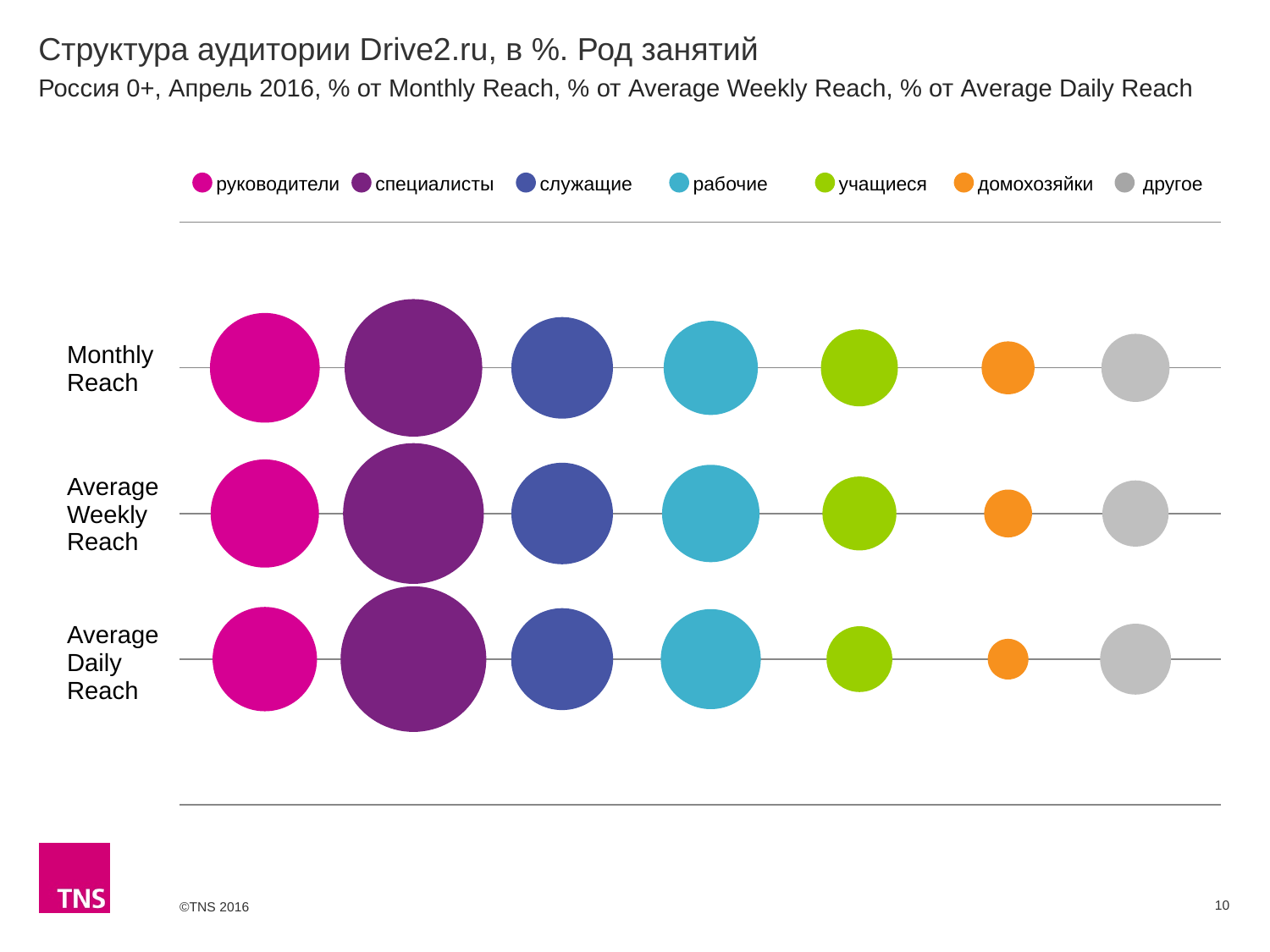
Which legend entry is shown in orange? домохозяйки Which occupation group has the largest bubble in the Average Daily Reach row? специалисты Which occupation group has the smallest bubble in the Monthly Reach row? домохозяйки What is the title of the chart on the slide? Структура аудитории Drive2.ru, в %. Род занятий In the Monthly Reach row, which bubble is larger: другое or домохозяйки? другое What kind of chart is shown on the slide? Bubble chart How many reach categories (rows) are plotted on the chart? 3 In the Average Weekly Reach row, which bubble is larger: руководители or служащие? руководители In the Average Daily Reach row, which bubble is larger: рабочие or учащиеся? рабочие How many series does the legend list? 7 Which occupation group has the smallest bubble in the Average Weekly Reach row? домохозяйки Which occupation group has the largest bubble in the Monthly Reach row? специалисты